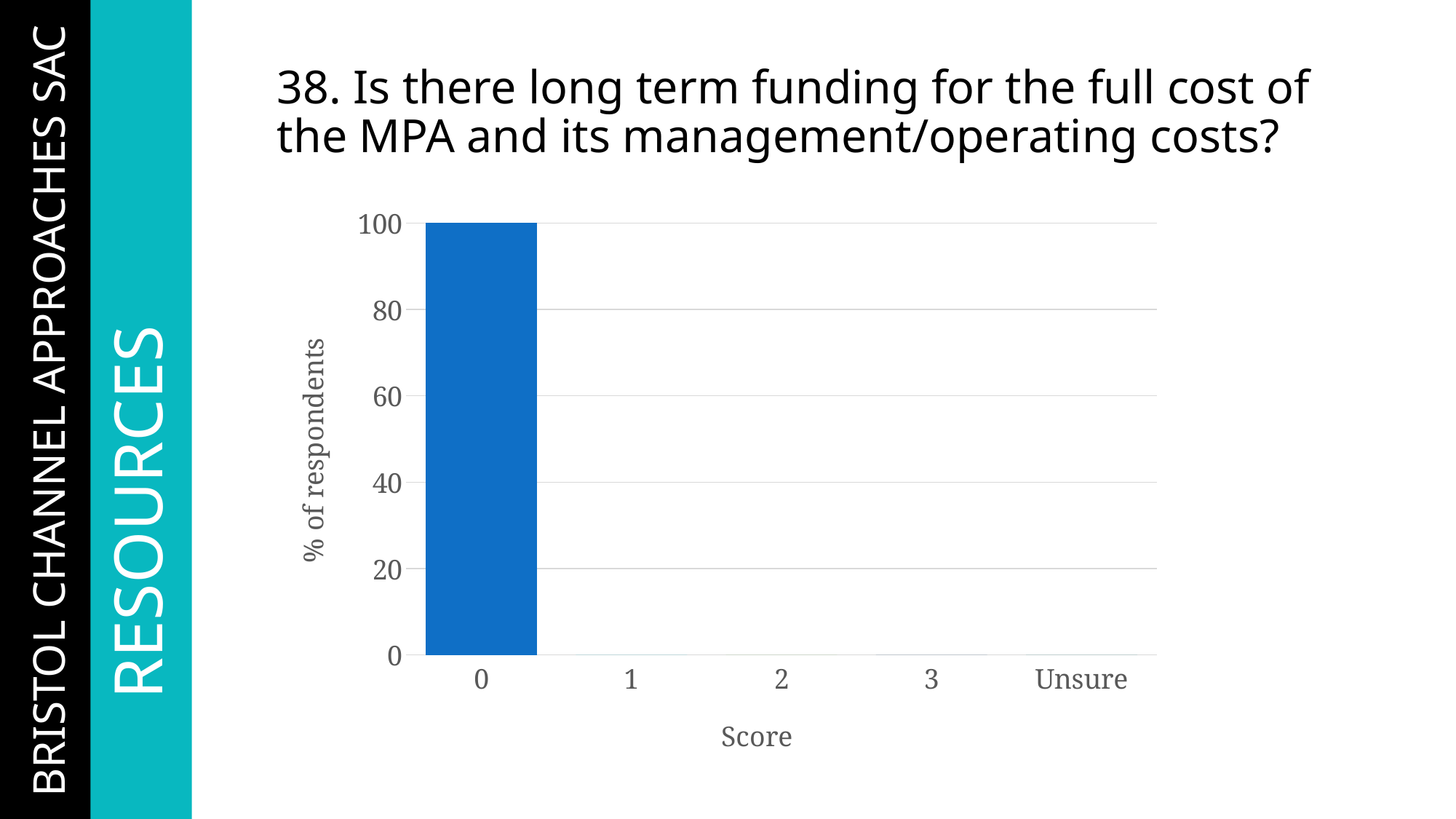
Is the value for score 0 greater or less than 80? greater Which score category has the highest percentage of respondents? 0 What type of chart is shown on the slide? bar chart What percentage of respondents gave a score of 2? 0 How many score categories are shown on the x axis? 5 Which is larger, the value for score 0 or the value for score 3? score 0 Is the value for Unsure greater or less than 20? less What percentage of respondents gave a score of 0? 100 What is the label of the y axis? % of respondents What is the label of the x axis? Score What is the difference between the value for score 0 and the value for score 1? 100 What is the last category on the x axis? Unsure